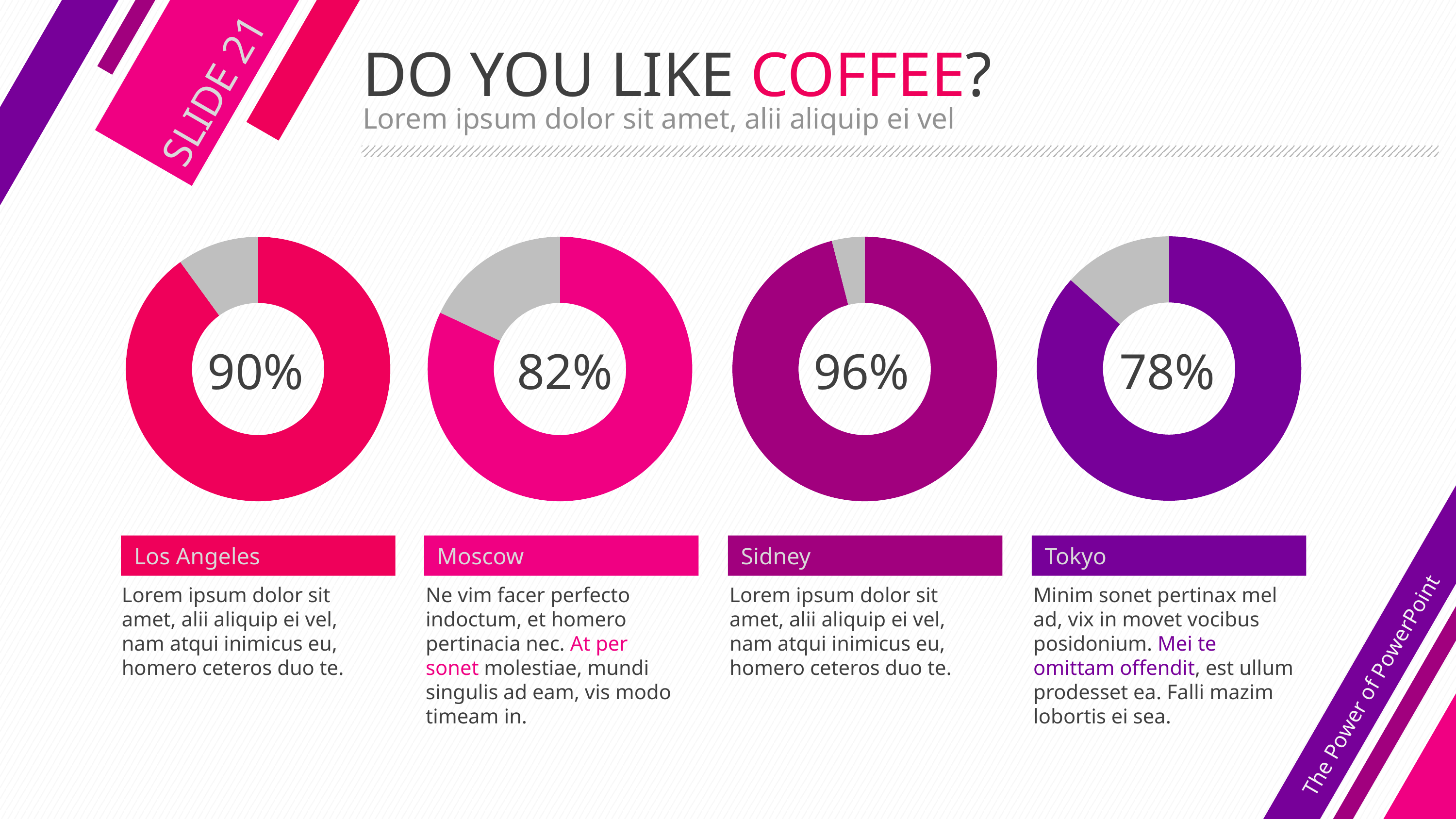
Which is larger, the Moscow percentage or the Tokyo percentage? Moscow What is the difference between the Los Angeles percentage and the Moscow percentage? 8% What percentage is shown in the Los Angeles donut chart? 90% Which city has the highest percentage among the four donut charts? Sidney What kind of chart is used to show each city's percentage? Donut chart What percentage is shown in the Moscow donut chart? 82% What percentage is shown in the Sidney donut chart? 96% How many donut charts are shown on the slide? 4 What percentage is shown in the Tokyo donut chart? 78% What is the difference between the Sidney percentage and the Tokyo percentage? 18% Which city has the lowest percentage among the four donut charts? Tokyo What is the title of the slide containing the donut charts? DO YOU LIKE COFFEE?